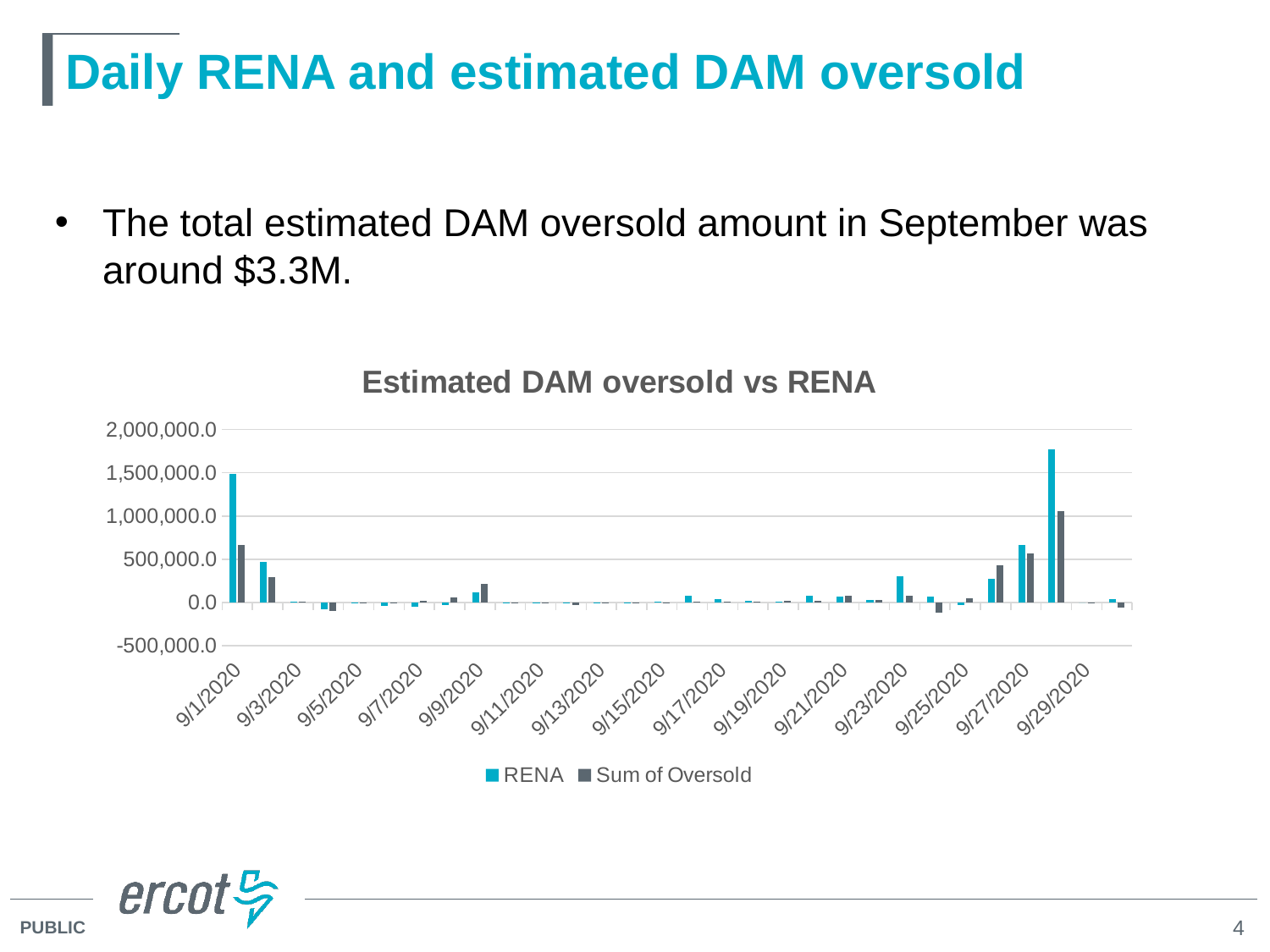
On 9/1/2020, which is larger: RENA or Sum of Oversold? RENA Is the highest RENA value in the chart greater or less than 1,500,000.0? greater Is the RENA value for 9/1/2020 greater or less than 1,000,000.0? greater Is the Sum of Oversold value for 9/3/2020 greater or less than 500,000.0? less How many date labels are shown on the x axis of the chart? 15 What type of chart is shown on the slide? Bar chart Which series contains the tallest bar in the chart? RENA Which series is shown in dark gray in the chart? Sum of Oversold What is the title of the chart? Estimated DAM oversold vs RENA How many series does the legend of the chart list? 2